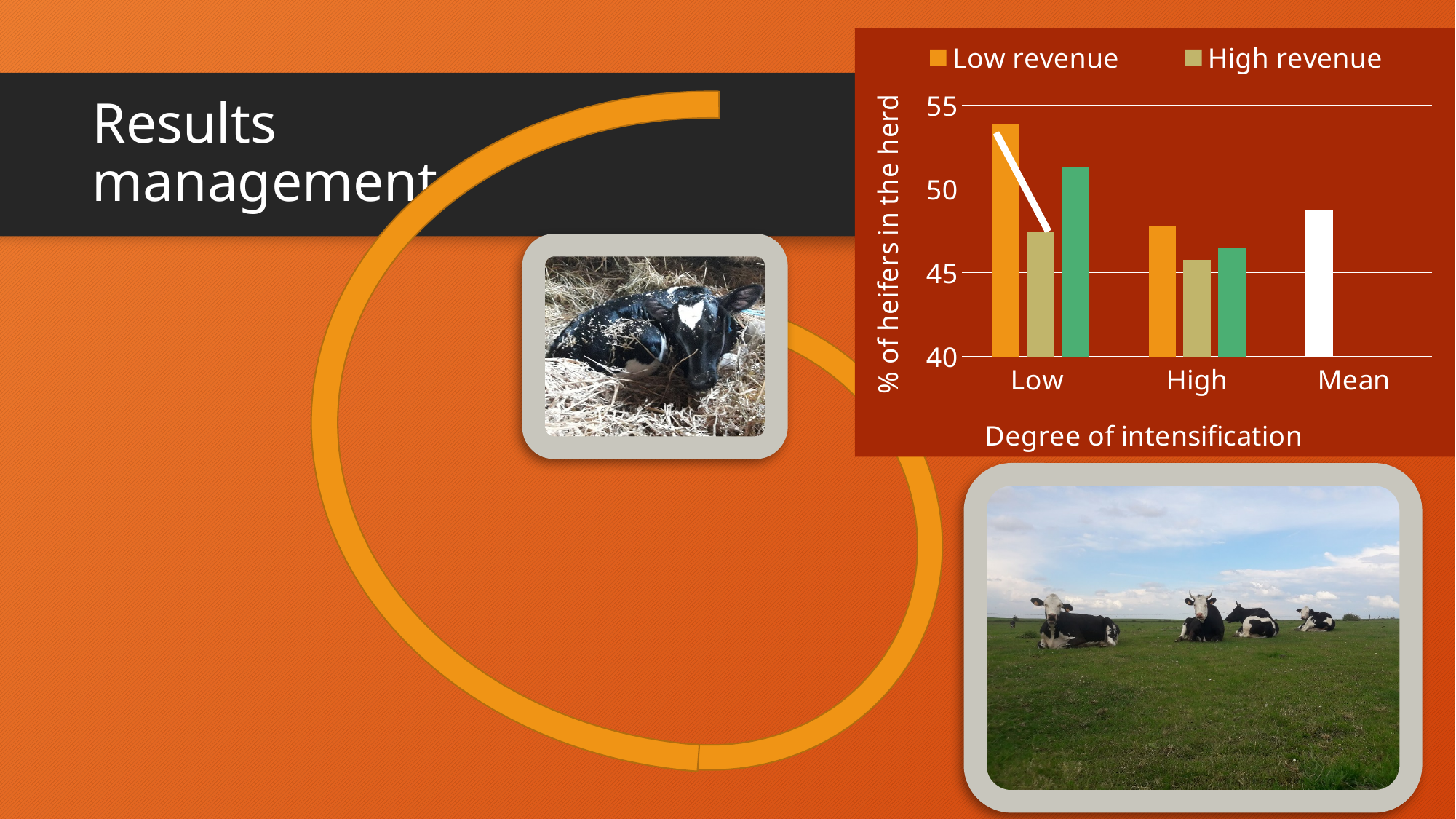
For the Low degree of intensification, which is larger: the Low revenue value or the High revenue value? Low revenue What is the label of the x axis of the chart? Degree of intensification Is the High revenue value for the Low degree of intensification greater or less than 50? less What is the label of the y axis of the chart? % of heifers in the herd How many categories are shown on the x axis of the chart? 3 Does the Low revenue series rise or fall from the Low to the High degree of intensification? fall For the Low revenue series, which degree of intensification has the higher value, Low or High? Low Is the Low revenue value for the High degree of intensification greater or less than 50? less How many series does the chart legend list? 2 Is the value of the Mean bar greater or less than 50? less What kind of chart is shown on the slide? bar chart